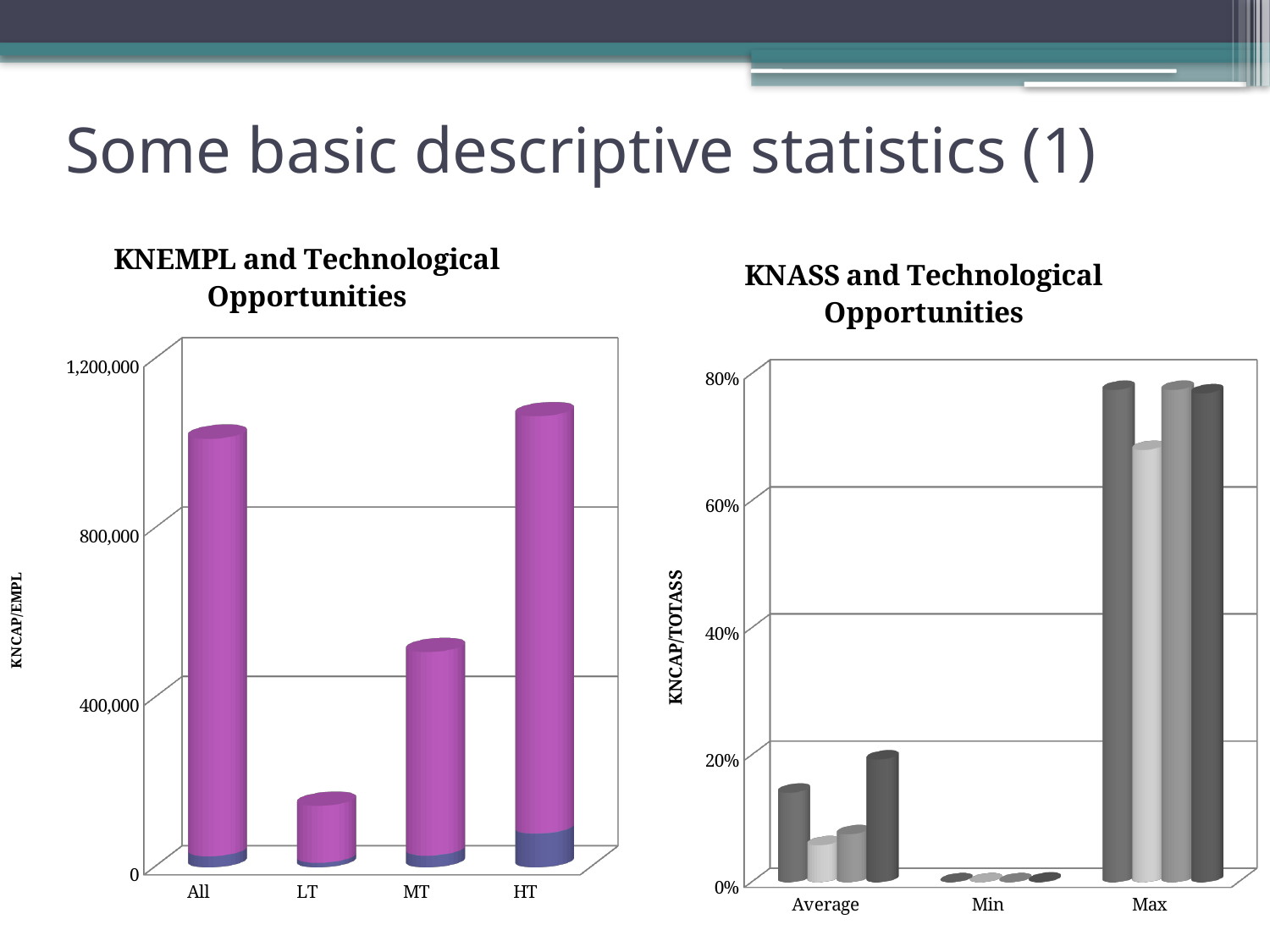
In the 'KNASS and Technological Opportunities' chart on the right, how many categories are shown on the x axis? 3 In the 'KNEMPL and Technological Opportunities' chart, which is larger, the value for All or the value for MT? All In the 'KNEMPL and Technological Opportunities' chart, is the value for HT greater or less than 800,000? greater In the 'KNEMPL and Technological Opportunities' chart, which category has the lowest bar? LT In the 'KNASS and Technological Opportunities' chart, are the bars for Max greater or less than 60%? greater What type of chart is the 'KNEMPL and Technological Opportunities' chart on the left? bar chart In the 'KNASS and Technological Opportunities' chart, which category has the lowest bars? Min In the 'KNEMPL and Technological Opportunities' chart, is the value for LT greater or less than 400,000? less In the 'KNEMPL and Technological Opportunities' chart, how many categories are shown on the x axis? 4 What is the y-axis label of the 'KNEMPL and Technological Opportunities' chart? KNCAP/EMPL In the 'KNEMPL and Technological Opportunities' chart, which category has the highest bar? HT